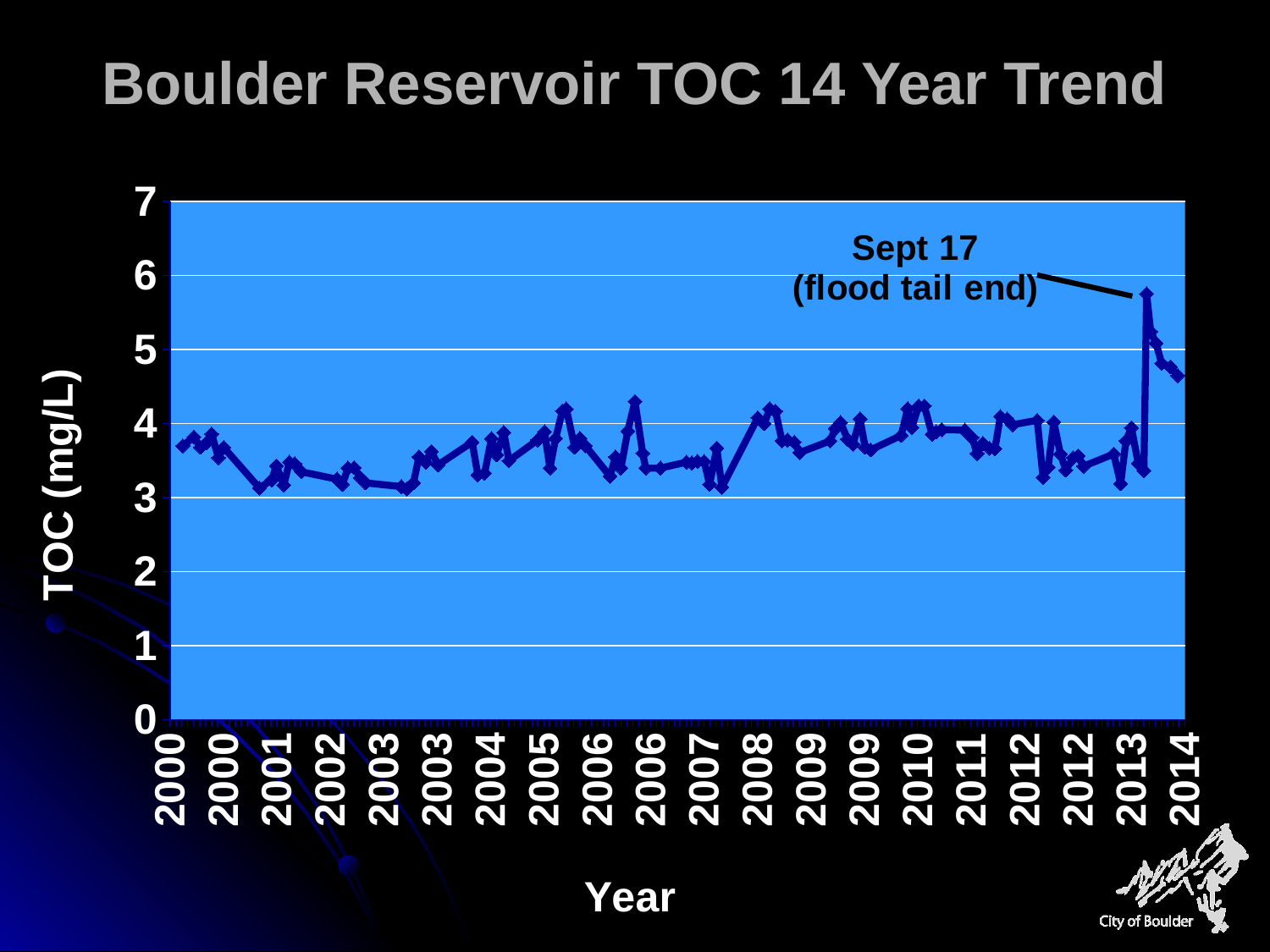
Are the TOC values in 2003 greater or less than 4? less What annotation labels the highest point on the chart? Sept 17 (flood tail end) Is the peak TOC value in 2013 greater or less than 6? less Which is higher, the TOC peak in 2013 or the TOC values in 2003? The 2013 peak What is the title of the chart? Boulder Reservoir TOC 14 Year Trend What kind of chart is shown on the slide? Line chart Is the first TOC value in 2000 greater or less than 3? greater In which year does the highest TOC value occur? 2013 After the Sept 17 peak, do the TOC values rise or fall? Fall How many data series are plotted on the chart? 1 Which year has higher TOC values, 2001 or 2010? 2010